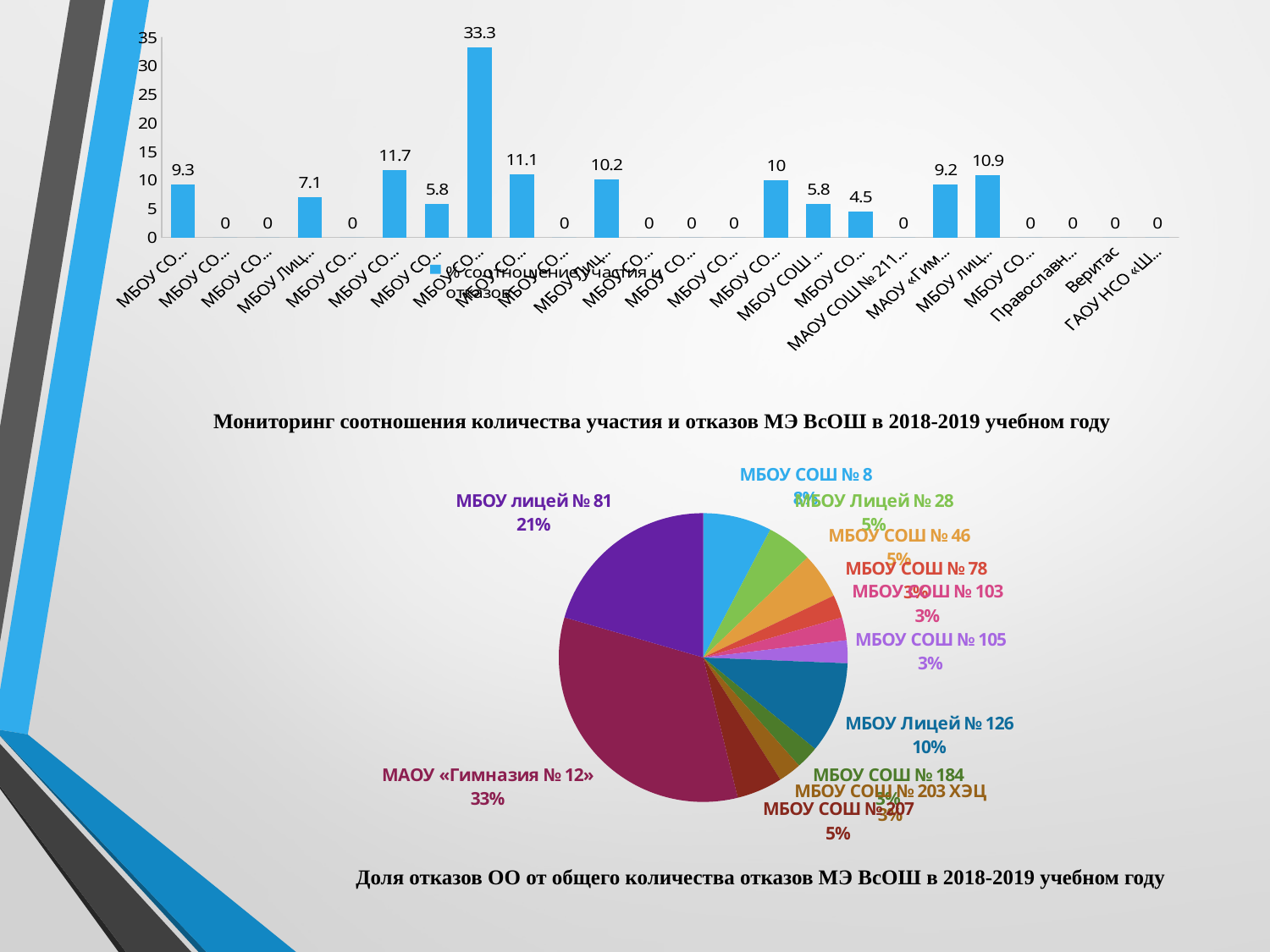
How many slices does the pie chart at the bottom of the slide have? 12 What kind of chart is the chart at the bottom of the slide? pie chart On the pie chart 'Доля отказов ОО от общего количества отказов МЭ ВсОШ в 2018-2019 учебном году', what share does МБОУ Лицей № 126 have? 10% On the pie chart 'Доля отказов ОО от общего количества отказов МЭ ВсОШ в 2018-2019 учебном году', what share does МБОУ лицей № 81 have? 21% What kind of chart is the chart at the top of the slide? bar chart On the bar chart at the top of the slide, what is the value for Веритас? 0 On the pie chart 'Доля отказов ОО от общего количества отказов МЭ ВсОШ в 2018-2019 учебном году', what share does МАОУ «Гимназия № 12» have? 33% On the bar chart at the top of the slide, what is the highest value shown? 33.3 On the pie chart 'Доля отказов ОО от общего количества отказов МЭ ВсОШ в 2018-2019 учебном году', which organisation has the largest share? МАОУ «Гимназия № 12» On the pie chart 'Доля отказов ОО от общего количества отказов МЭ ВсОШ в 2018-2019 учебном году', which has the larger share: МБОУ Лицей № 126 or МБОУ СОШ № 8? МБОУ Лицей № 126 On the pie chart 'Доля отказов ОО от общего количества отказов МЭ ВсОШ в 2018-2019 учебном году', what is the difference between the shares of МАОУ «Гимназия № 12» and МБОУ лицей № 81? 12% How many bars (categories) are shown on the bar chart at the top of the slide? 24